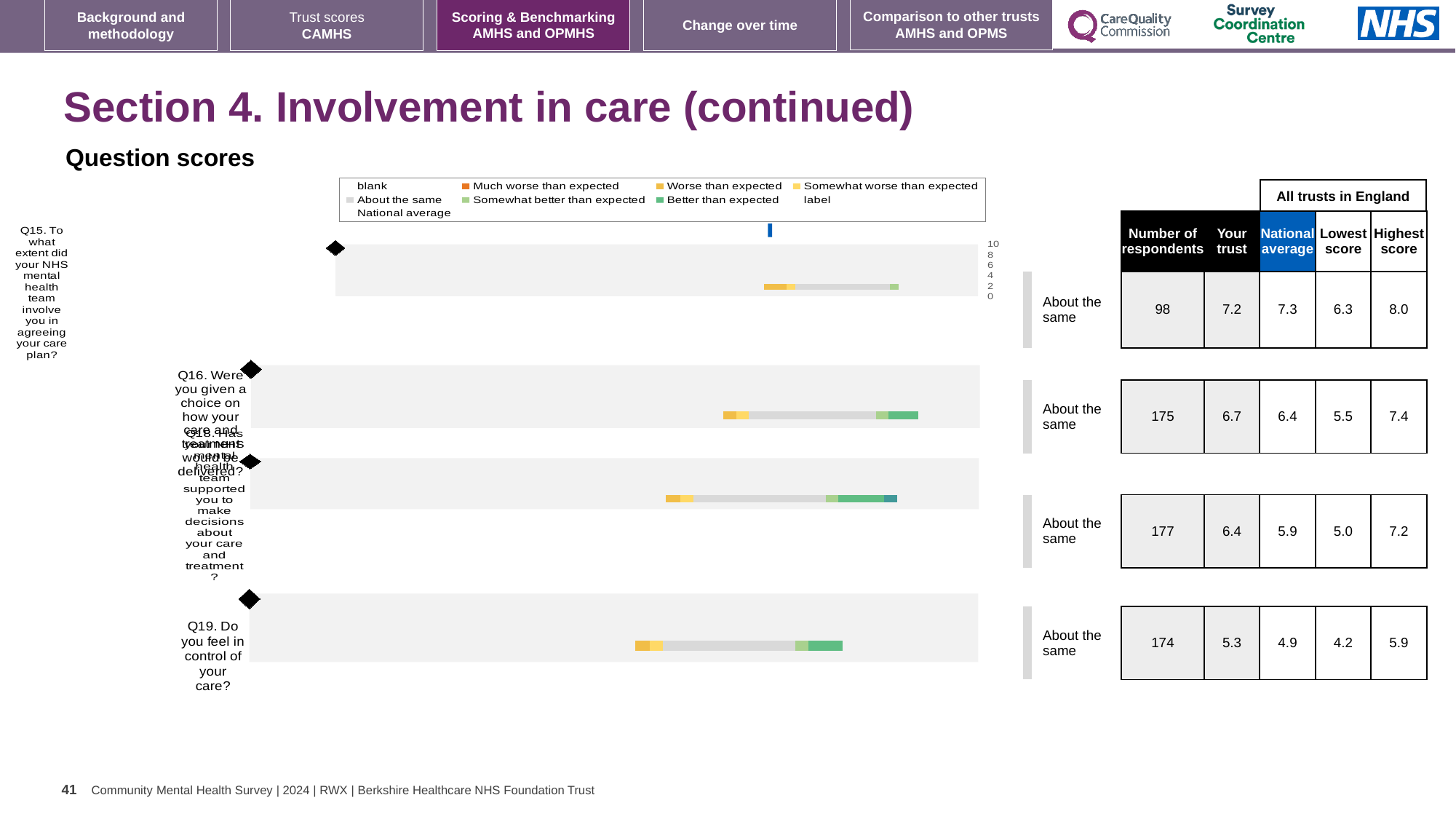
Which question has the largest number of respondents in the table? Q18 How many questions (bars) are plotted in the question scores chart? 4 In the table beside the chart, how many respondents are listed for Q15? 98 What benchmark category is shown next to each question bar in the chart? About the same What kind of chart is used to show the question scores on this slide? bar chart What is the difference between the highest score and the lowest score for Q15 in the table? 1.7 What is the 'Your trust' score for Q16 in the table beside the chart? 6.7 For Q16, which is larger: the 'Your trust' score or the national average? Your trust Which question has the highest 'Your trust' score in the table? Q15 What is the highest score across all trusts in England for Q19, according to the table? 5.9 What is the national average score for Q18 in the table beside the chart? 5.9 Which question has the lowest 'Your trust' score in the table? Q19